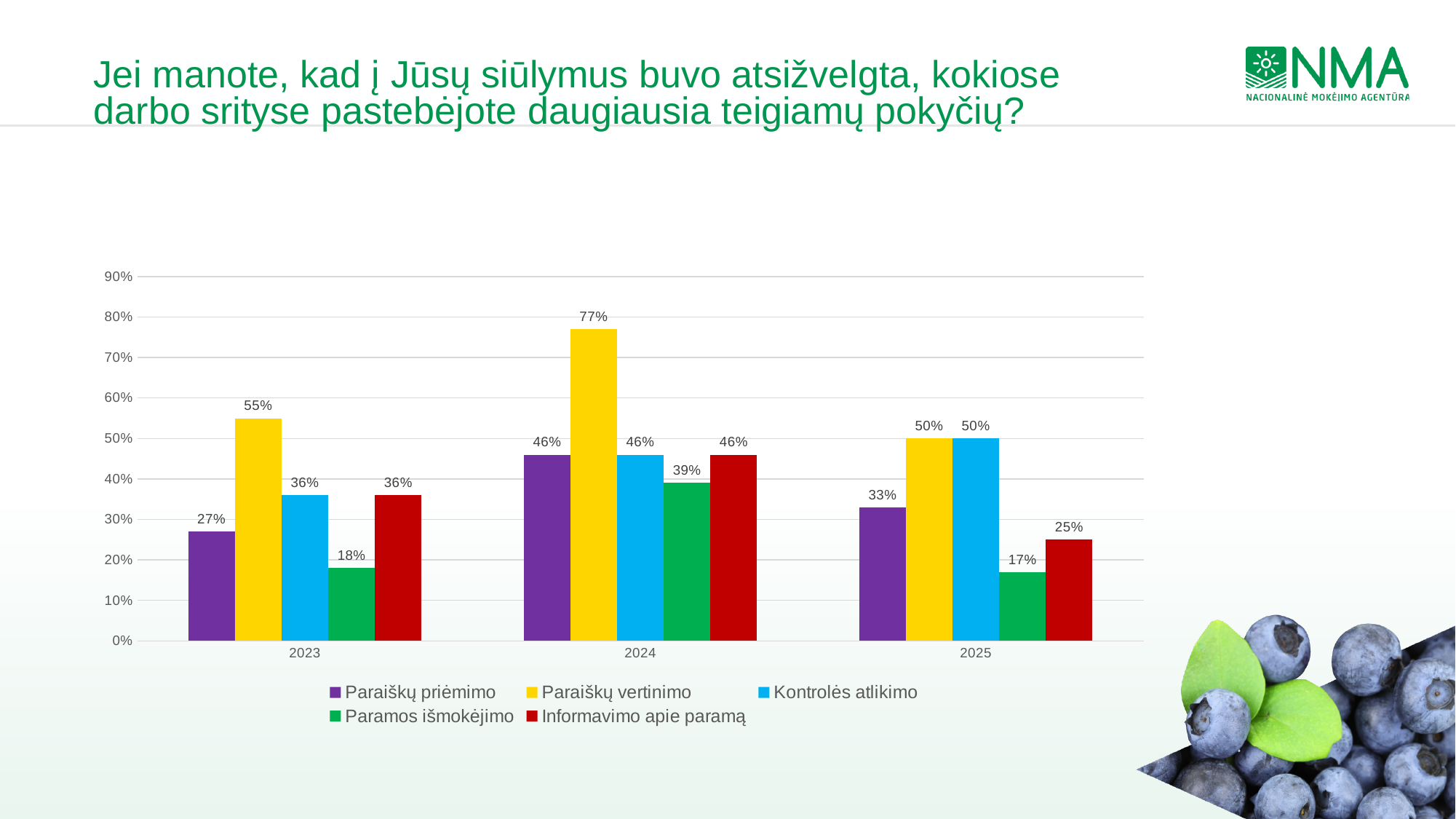
Which is larger: Paraiškų priėmimo in 2024 or Paraiškų priėmimo in 2025? Paraiškų priėmimo in 2024 Does the value for Paramos išmokėjimo rise or fall from 2024 to 2025? Fall What kind of chart is shown on the slide? Bar chart Which series has the highest value in 2024? Paraiškų vertinimo Which colour represents Kontrolės atlikimo in the chart? Blue Which series has the lowest value in 2025? Paramos išmokėjimo What is the value for Paraiškų vertinimo in 2024? 77% How many year categories are shown on the x axis? 3 What is the difference between Paraiškų vertinimo in 2024 and in 2023? 22% How many series does the legend list? 5 What is the value for Paramos išmokėjimo in 2023? 18% What is the value for Informavimo apie paramą in 2025? 25%